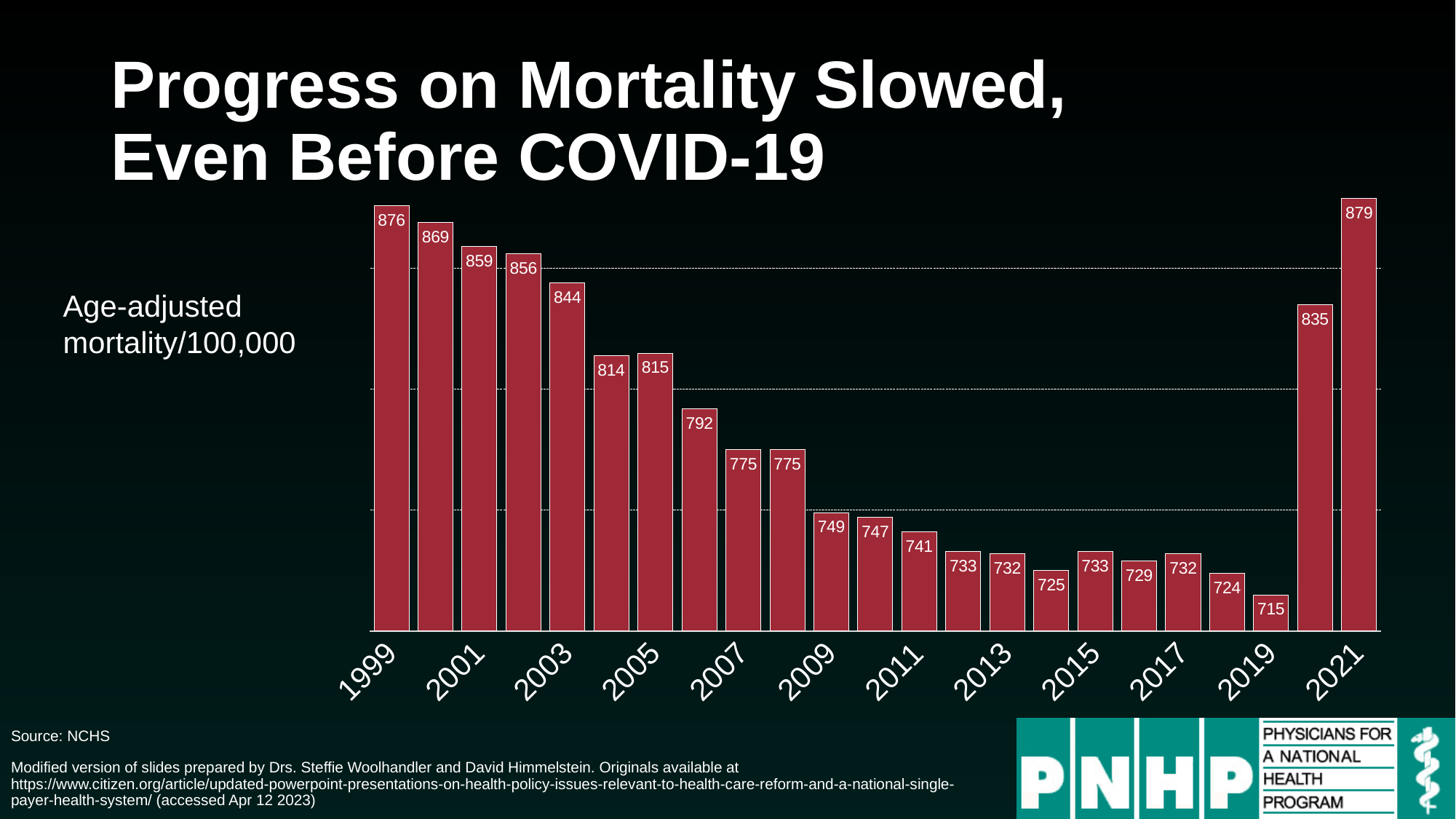
What is the age-adjusted mortality per 100,000 for 2009? 749 What is the age-adjusted mortality per 100,000 for 2019? 715 How many bars are shown in the chart? 23 Which year has a higher age-adjusted mortality, 2003 or 2007? 2003 What is the difference in age-adjusted mortality between 1999 and 2009? 127 Which year has the lowest age-adjusted mortality? 2019 What is the age-adjusted mortality per 100,000 for 1999? 876 What is the age-adjusted mortality per 100,000 for 2021? 879 What is the difference in age-adjusted mortality between 2021 and 2019? 164 What kind of chart is shown on the slide? Bar chart Does age-adjusted mortality rise or fall from 1999 to 2019? Fall Which year has the highest age-adjusted mortality? 2021